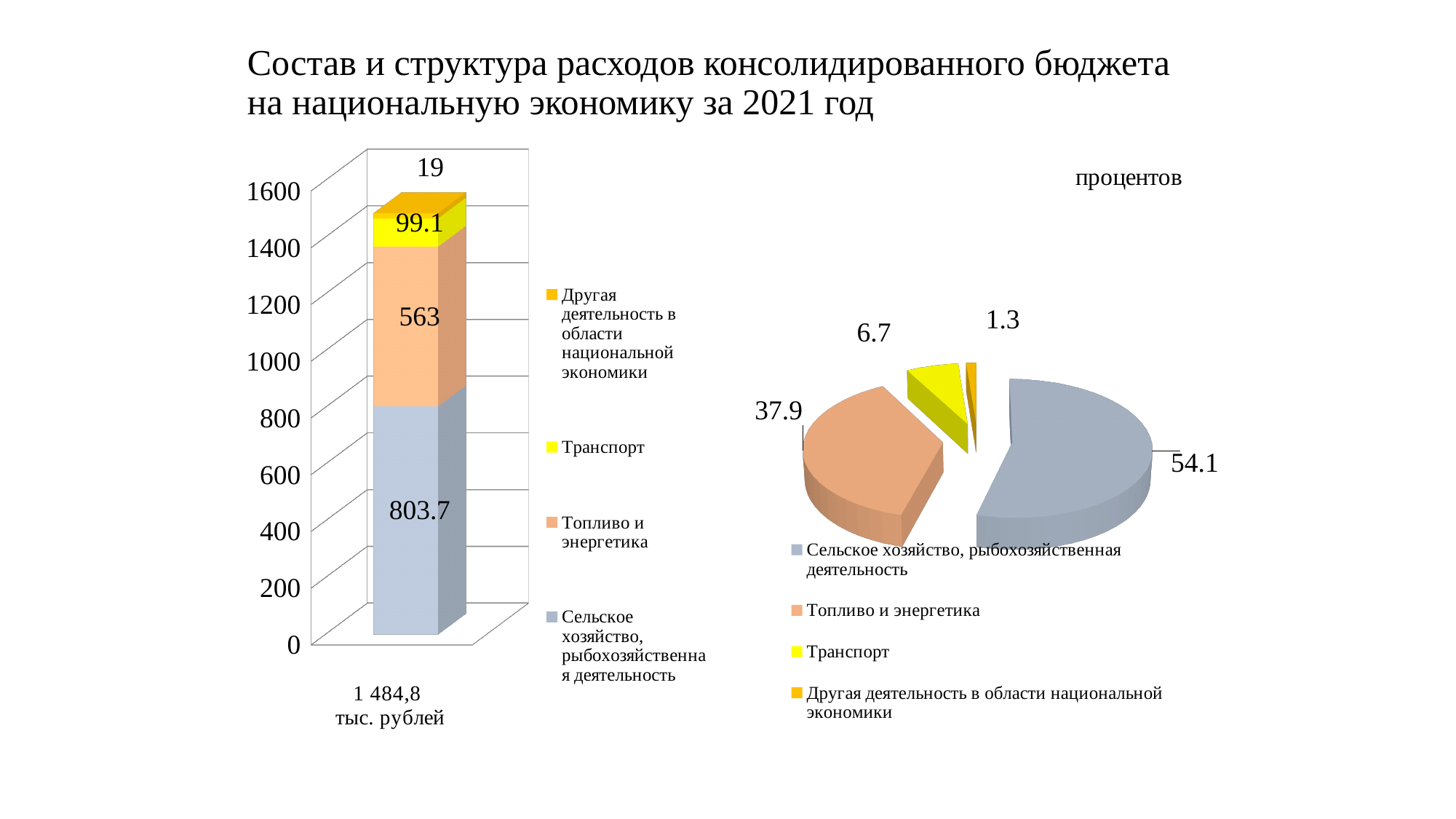
On the pie chart on the right, what is the share for Транспорт? 6.7 On the stacked bar chart on the left, what is the value for Топливо и энергетика? 563 On the pie chart on the right, what is the share for Сельское хозяйство, рыбохозяйственная деятельность? 54.1 On the stacked bar chart on the left, which segment is the smallest? Другая деятельность в области национальной экономики On the pie chart on the right, which is larger: the slice for Топливо и энергетика or the slice for Транспорт? Топливо и энергетика On the pie chart on the right, which category has the largest slice? Сельское хозяйство, рыбохозяйственная деятельность On the stacked bar chart on the left, what is the value for Транспорт? 99.1 What kind of chart is shown on the right of the slide? Pie chart What kind of chart is shown on the left of the slide? Stacked bar chart On the stacked bar chart on the left, what is the value for Сельское хозяйство, рыбохозяйственная деятельность? 803.7 On the stacked bar chart on the left, how many series does the legend list? 4 On the stacked bar chart on the left, what is the difference between the values for Сельское хозяйство, рыбохозяйственная деятельность and Топливо и энергетика? 240.7